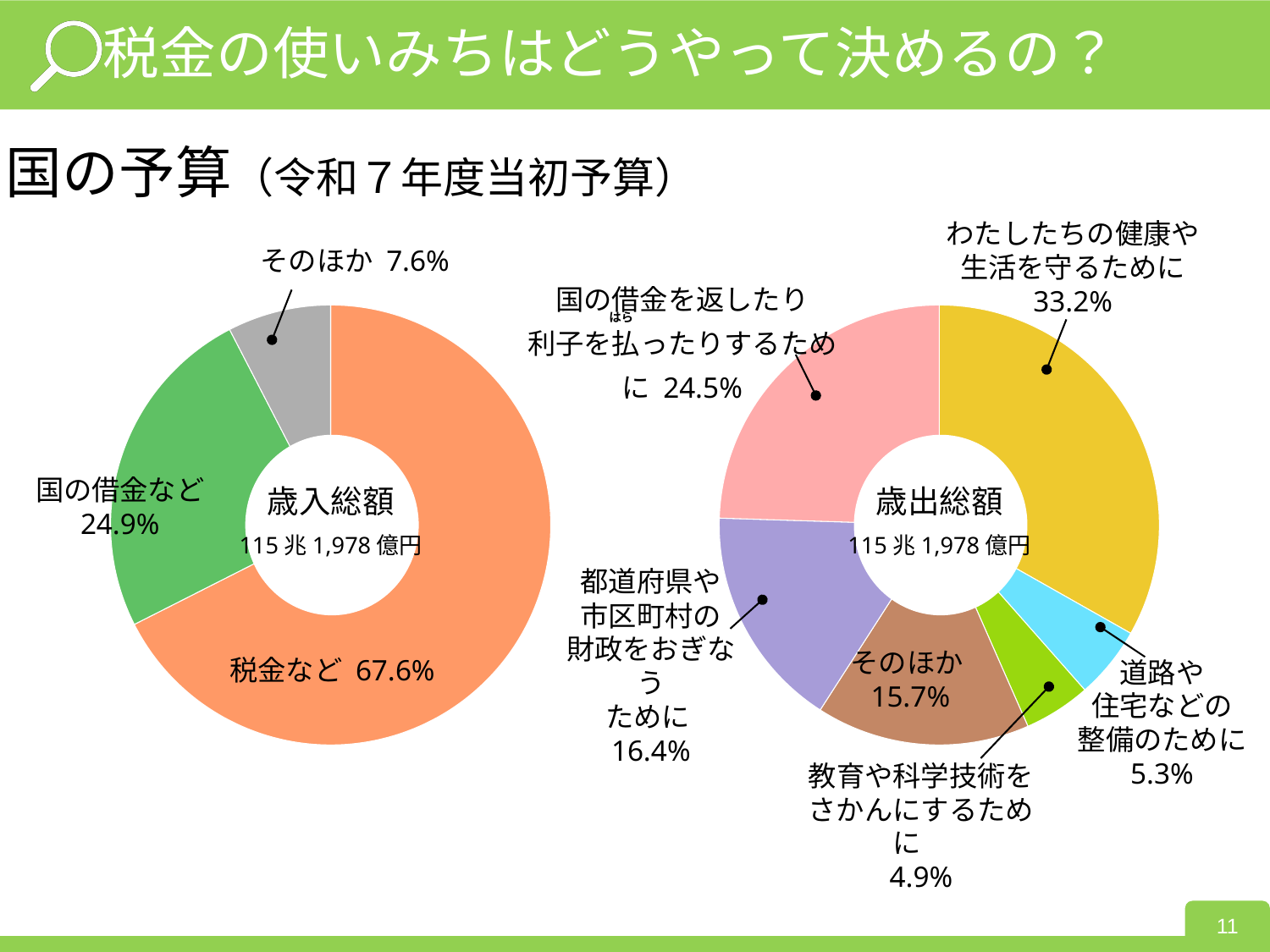
In the 歳出総額 chart on the right, which category has the largest share? わたしたちの健康や生活を守るために In the 歳入総額 chart on the left, which slice is the smallest? そのほか In the 歳入総額 chart on the left, what share is 税金など? 67.6% In the 歳入総額 chart on the left, what is the total amount shown in the centre? 115兆1,978億円 In the 歳出総額 chart on the right, what share is 教育や科学技術をさかんにするために? 4.9% What kind of chart is the 歳出総額 chart on the right? Pie (donut) chart In the 歳入総額 chart on the left, how many slices are there? 3 In the 歳出総額 chart on the right, what share is わたしたちの健康や生活を守るために? 33.2% In the 歳出総額 chart on the right, which is larger: 都道府県や市区町村の財政をおぎなうために or 国の借金を返したり利子を払ったりするために? 国の借金を返したり利子を払ったりするために In the 歳出総額 chart on the right, how many slices are there? 6 In the 歳入総額 chart on the left, what share is 国の借金など? 24.9% In the 歳入総額 chart on the left, what is the difference between 税金など and 国の借金など? 42.7%